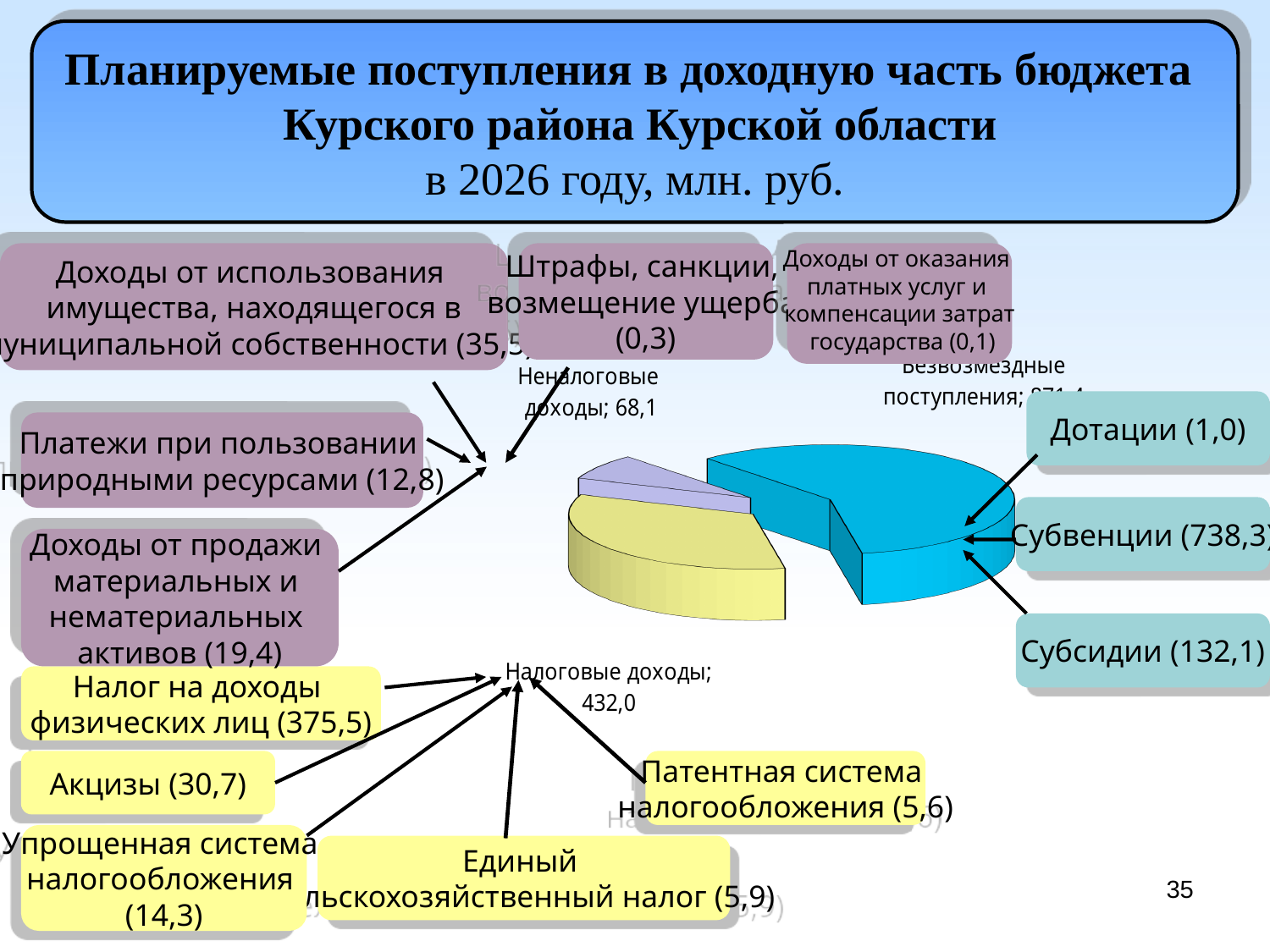
Which is larger in the pie chart: Налоговые доходы or Неналоговые доходы? Налоговые доходы What kind of chart is shown on the slide? Pie chart Which slice of the pie chart is the largest? Безвозмездные поступления What is the title of the slide containing the pie chart? Планируемые поступления в доходную часть бюджета Курского района Курской области в 2026 году, млн. руб. What colour is the Налоговые доходы slice in the pie chart? Yellow What is the value for Налоговые доходы in the pie chart? 432,0 What is the value for Неналоговые доходы in the pie chart? 68,1 Which slice of the pie chart is the smallest? Неналоговые доходы How many slices does the pie chart have? 3 Which is larger in the pie chart: Безвозмездные поступления or Налоговые доходы? Безвозмездные поступления What is the difference between Налоговые доходы and Неналоговые доходы in the pie chart? 363,9